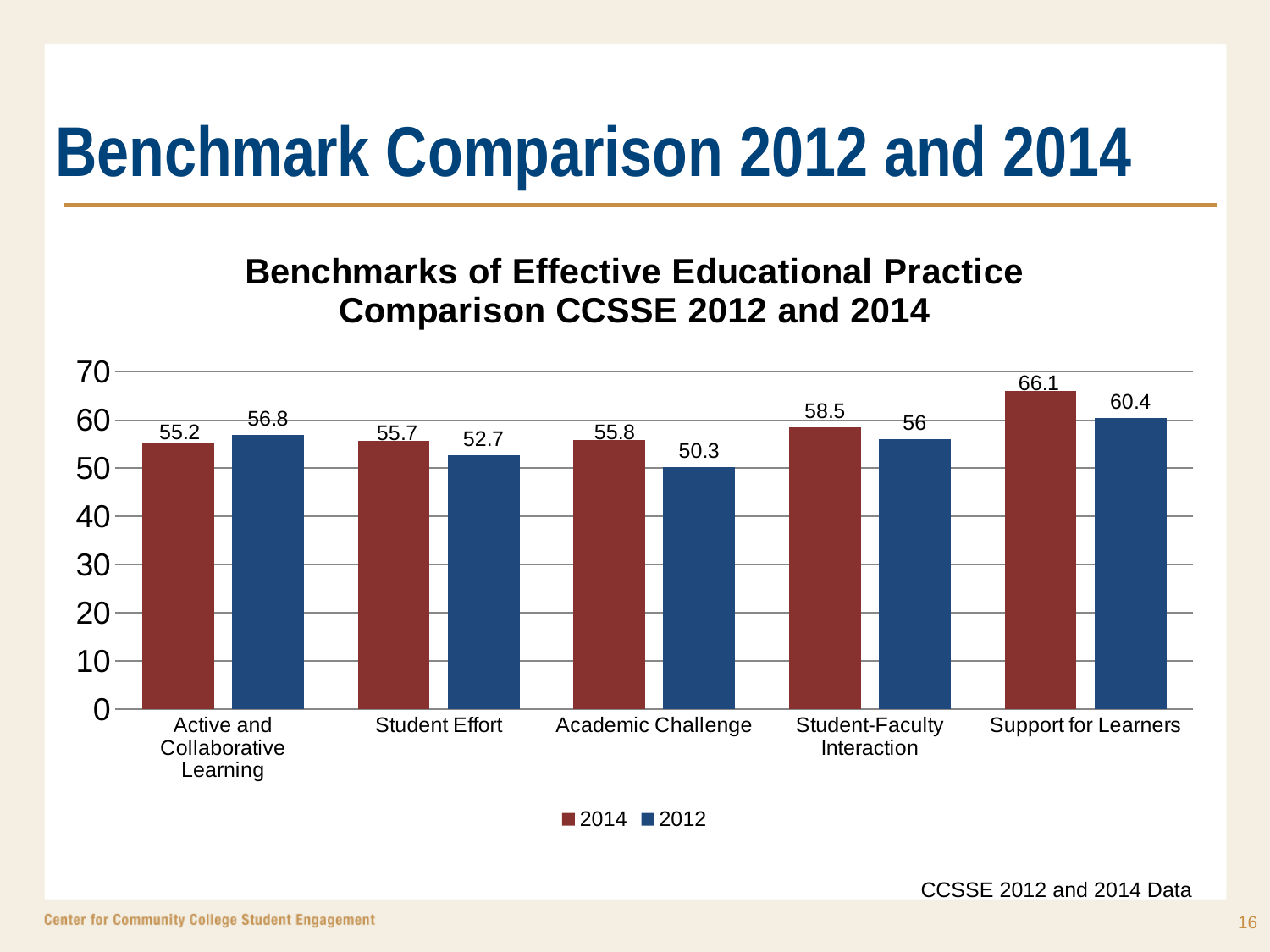
Which category has the highest 2014 value? Support for Learners What is the 2012 value for Academic Challenge? 50.3 Is the 2014 value for Student-Faculty Interaction greater or less than 60? less How many benchmark categories are shown on the x axis? 5 What is the difference between the 2014 and 2012 values for Support for Learners? 5.7 What is the difference between the 2014 and 2012 values for Academic Challenge? 5.5 What is the 2014 value for Support for Learners? 66.1 For Active and Collaborative Learning, which year has the larger value, 2014 or 2012? 2012 Which category has the lowest 2012 value? Academic Challenge What is the 2012 value for Student-Faculty Interaction? 56 What type of chart is shown on the slide? Bar chart How many series does the legend list? 2